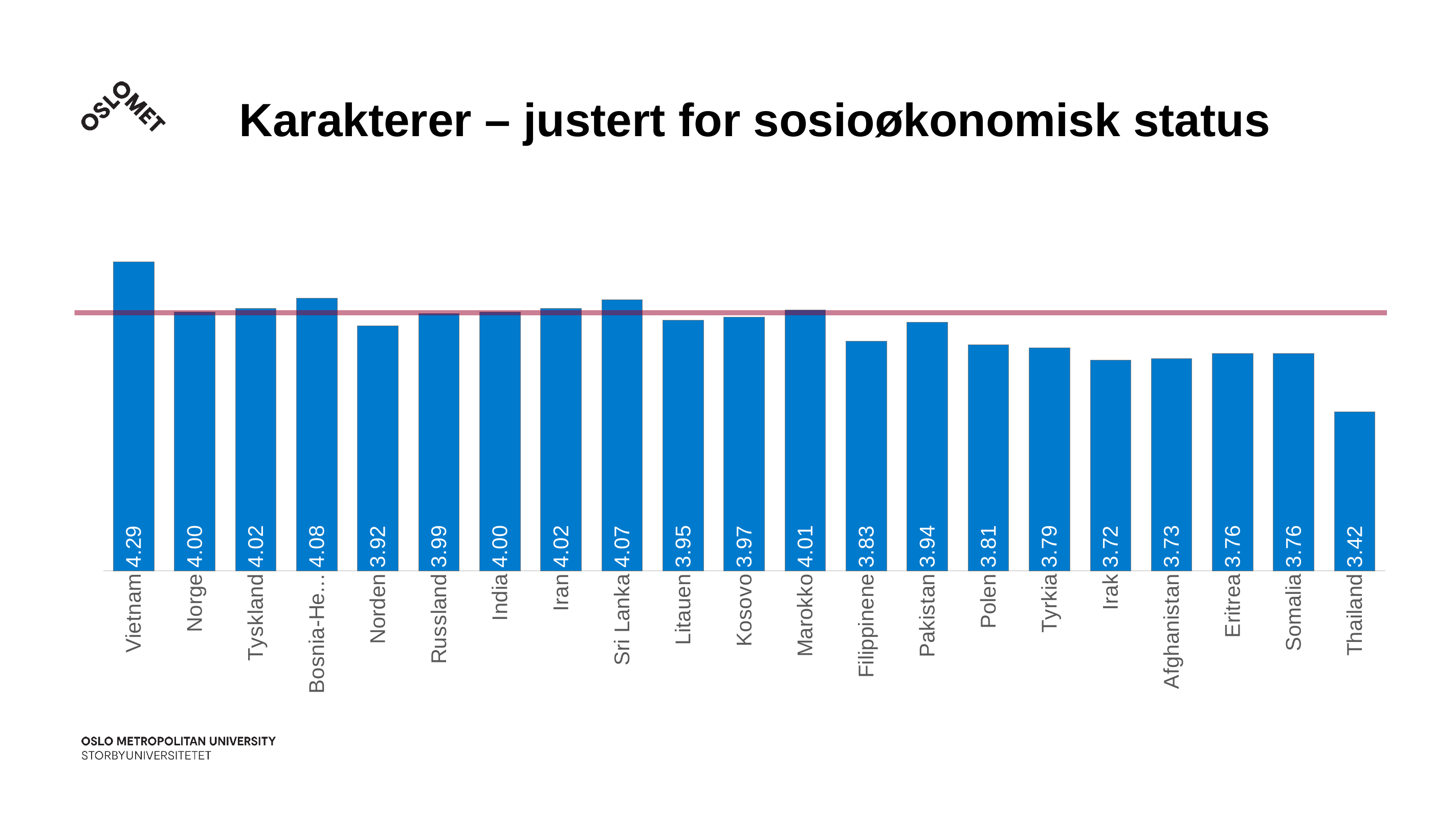
What is the title of the slide? Karakterer – justert for sosioøkonomisk status Which category has the highest value? Vietnam What is the value for Vietnam? 4.29 What is the difference between the values for Norge and Irak? 0.28 Which category has the lowest value? Thailand How many categories are shown in the chart? 21 Which is larger, the value for Sri Lanka or the value for Pakistan? Sri Lanka What kind of chart is shown on the slide? Bar chart What is the value for Sri Lanka? 4.07 What is the value for Thailand? 3.42 What is the difference between the values for Vietnam and Thailand? 0.87 What is the value for Filippinene? 3.83